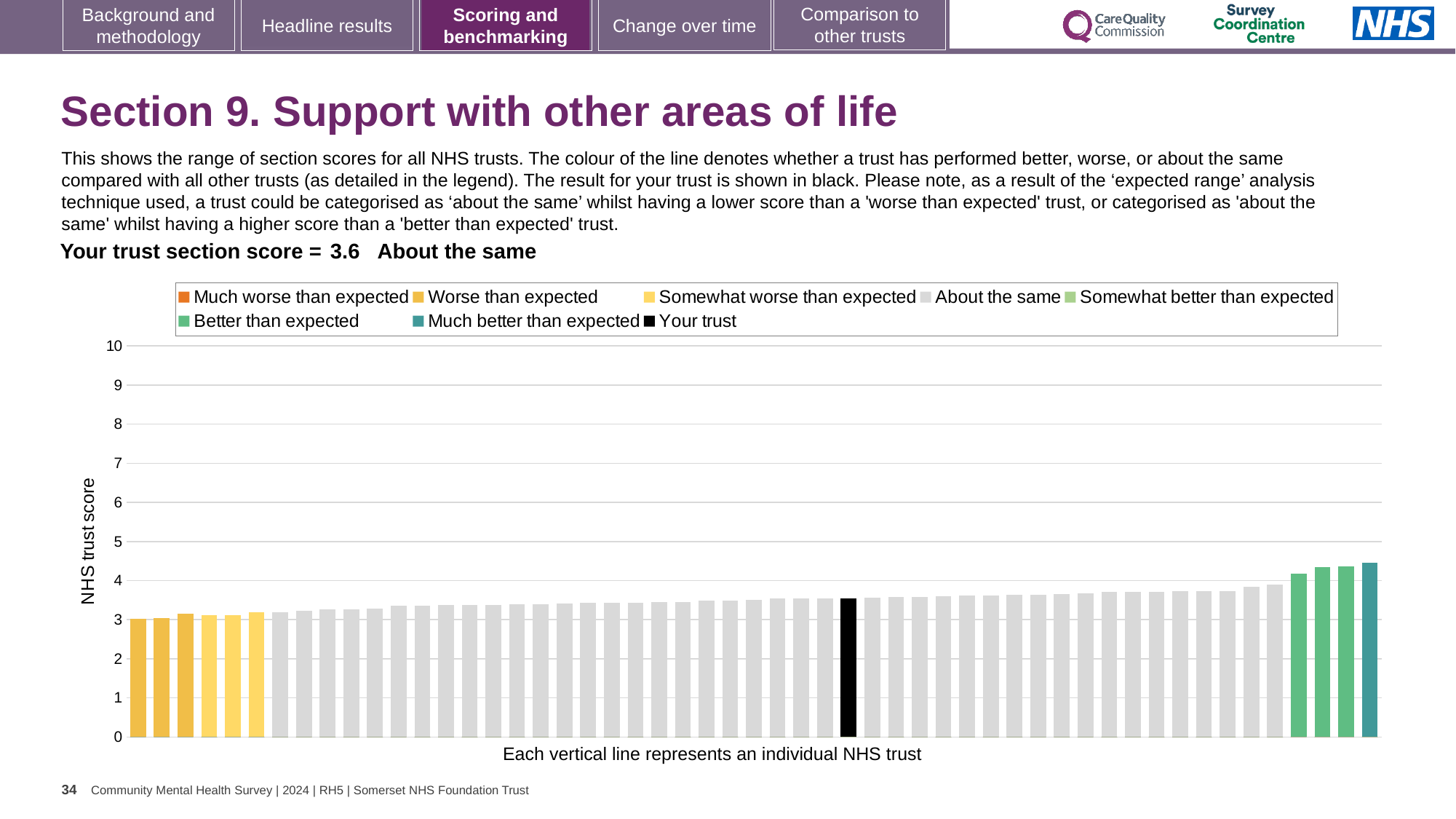
How many bars are coloured as 'Worse than expected'? 3 What kind of chart is shown on the slide? Bar chart Is the value of the black 'Your trust' bar greater or less than 4? less Which performance category is your trust placed in for this section? About the same What is the section score for your trust shown on the slide? 3.6 Which legend category does the tallest bar in the chart belong to? Much better than expected Is the value of the tallest bar in the chart greater or less than 4? greater Do the bar values rise or fall from left to right across the chart? Rise What is the label on the vertical axis of the chart? NHS trust score Which legend category does the shortest bar in the chart belong to? Worse than expected Is the value of the tallest bar in the chart greater or less than 5? less How many entries does the chart legend list? 8